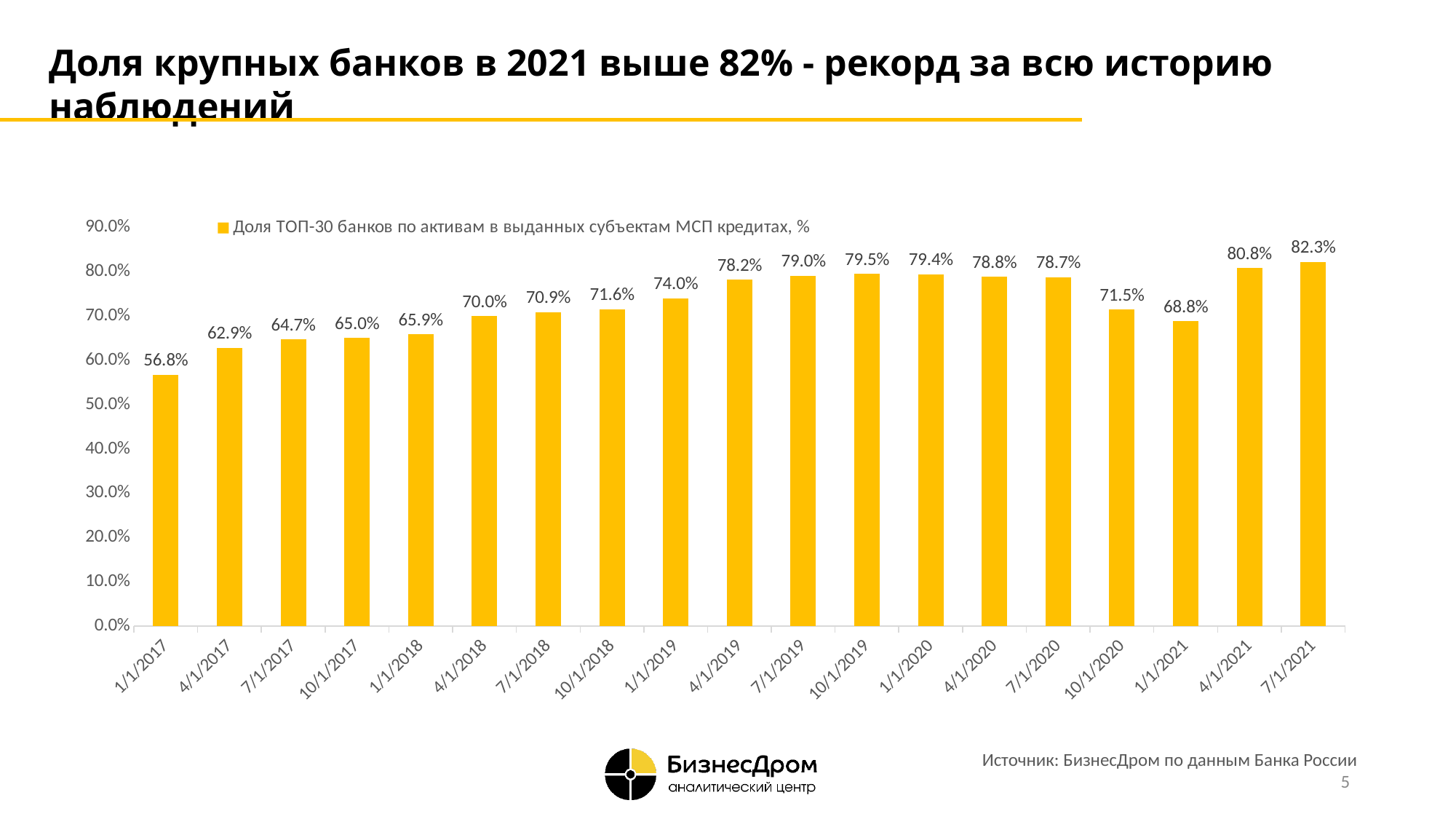
What is the value for 7/1/2021? 82.3% Which is larger, the value for 1/1/2021 or the value for 10/1/2020? 10/1/2020 What is the value for 10/1/2020? 71.5% Is the value for 4/1/2019 greater or less than 70.0%? greater Which date has the highest value? 7/1/2021 How many series does the legend list? 1 What kind of chart is shown on the slide? bar chart What is the difference between the values for 7/1/2021 and 1/1/2017? 25.5% Which date has the lowest value? 1/1/2017 How many bars are plotted on the chart? 19 What is the value for 1/1/2017? 56.8% Do the values rise or fall from 1/1/2017 to 10/1/2019? rise